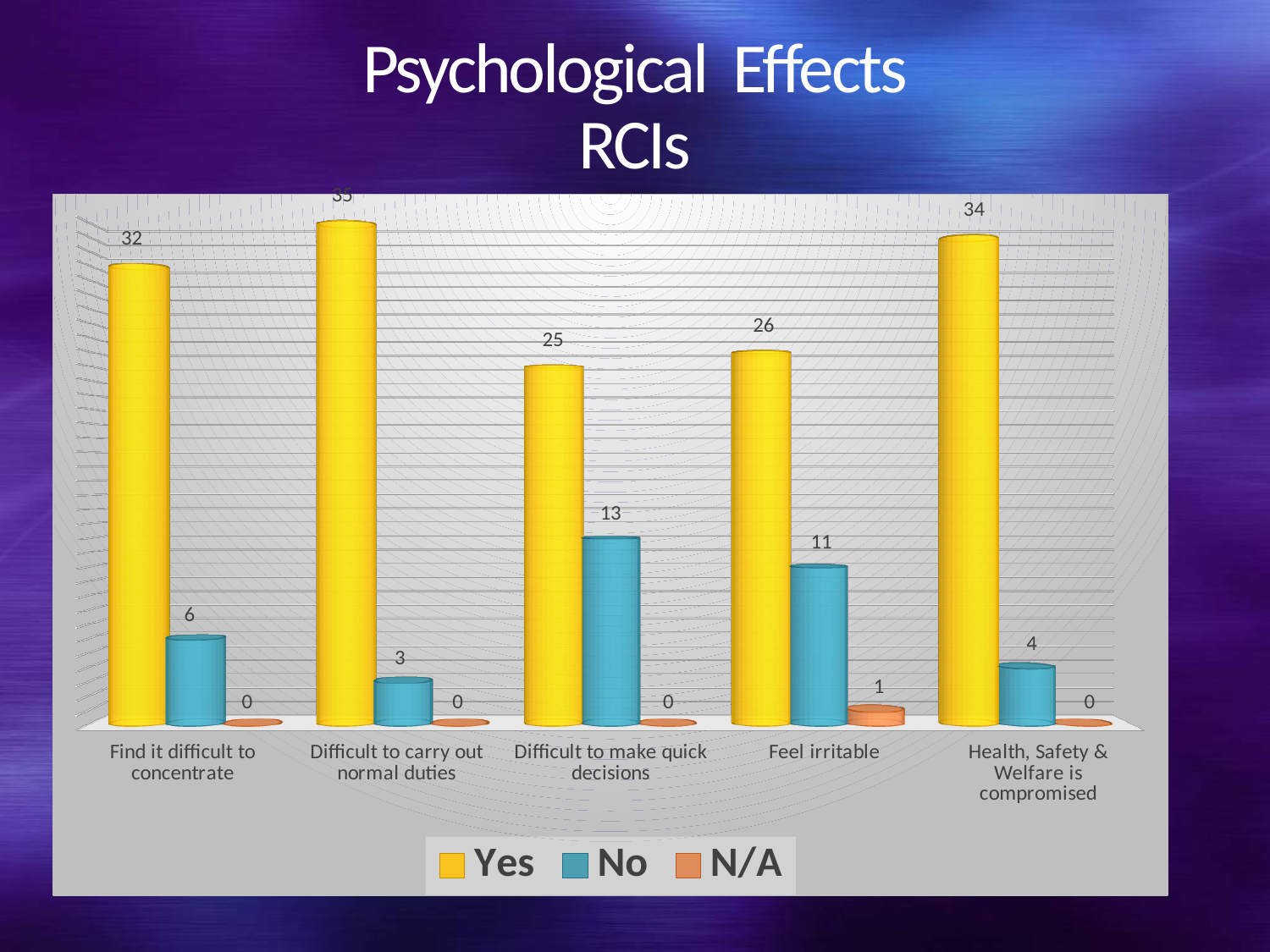
How many series does the legend list? 3 Which category has the highest Yes value? Difficult to carry out normal duties What is the difference between the Yes and No values for "Feel irritable"? 15 What is the total of the Yes, No and N/A values for "Difficult to make quick decisions"? 38 Which category has the lowest No value? Difficult to carry out normal duties How many categories are shown on the x axis? 5 Which is larger: the No value for "Find it difficult to concentrate" or the No value for "Health, Safety & Welfare is compromised"? Find it difficult to concentrate What is the Yes value for "Find it difficult to concentrate"? 32 What is the No value for "Difficult to make quick decisions"? 13 What is the N/A value for "Feel irritable"? 1 What kind of chart is shown on the slide? Bar chart Which colour represents the Yes series in the legend? Yellow